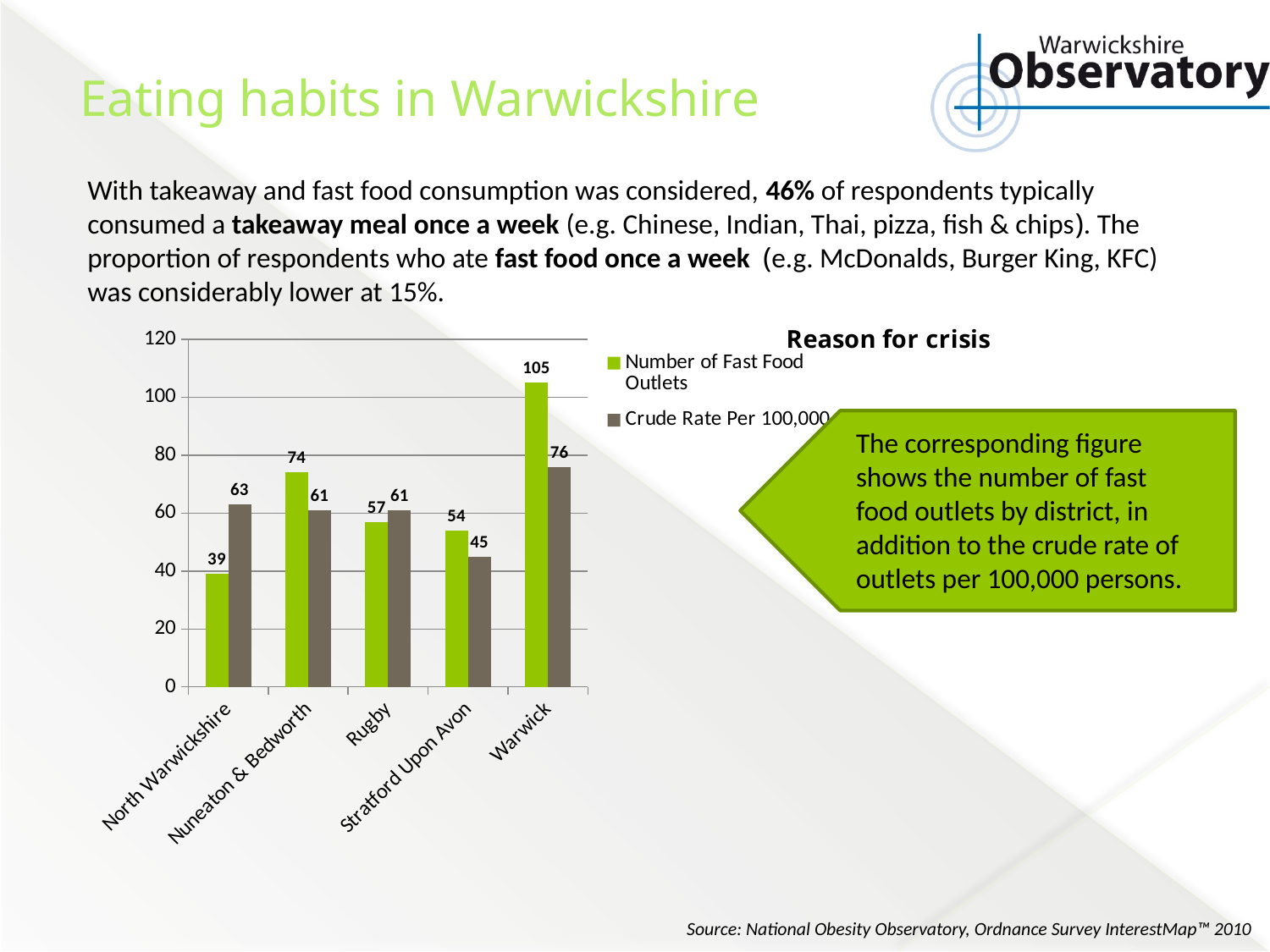
Which district has the highest Number of Fast Food Outlets? Warwick What is the Number of Fast Food Outlets for Rugby? 57 What kind of chart is shown on the slide? Bar chart Which district has the lowest Crude Rate Per 100,000? Stratford Upon Avon What is the Crude Rate Per 100,000 for North Warwickshire? 63 What is the title of the chart? Reason for crisis What is the Number of Fast Food Outlets for Warwick? 105 Is the Number of Fast Food Outlets for Warwick greater or less than 100? greater Which is larger for Nuneaton & Bedworth: the Number of Fast Food Outlets or the Crude Rate Per 100,000? Number of Fast Food Outlets How many series does the chart's legend list? 2 What is the difference between the Number of Fast Food Outlets in Warwick and in North Warwickshire? 66 How many districts are shown on the x axis of the chart? 5